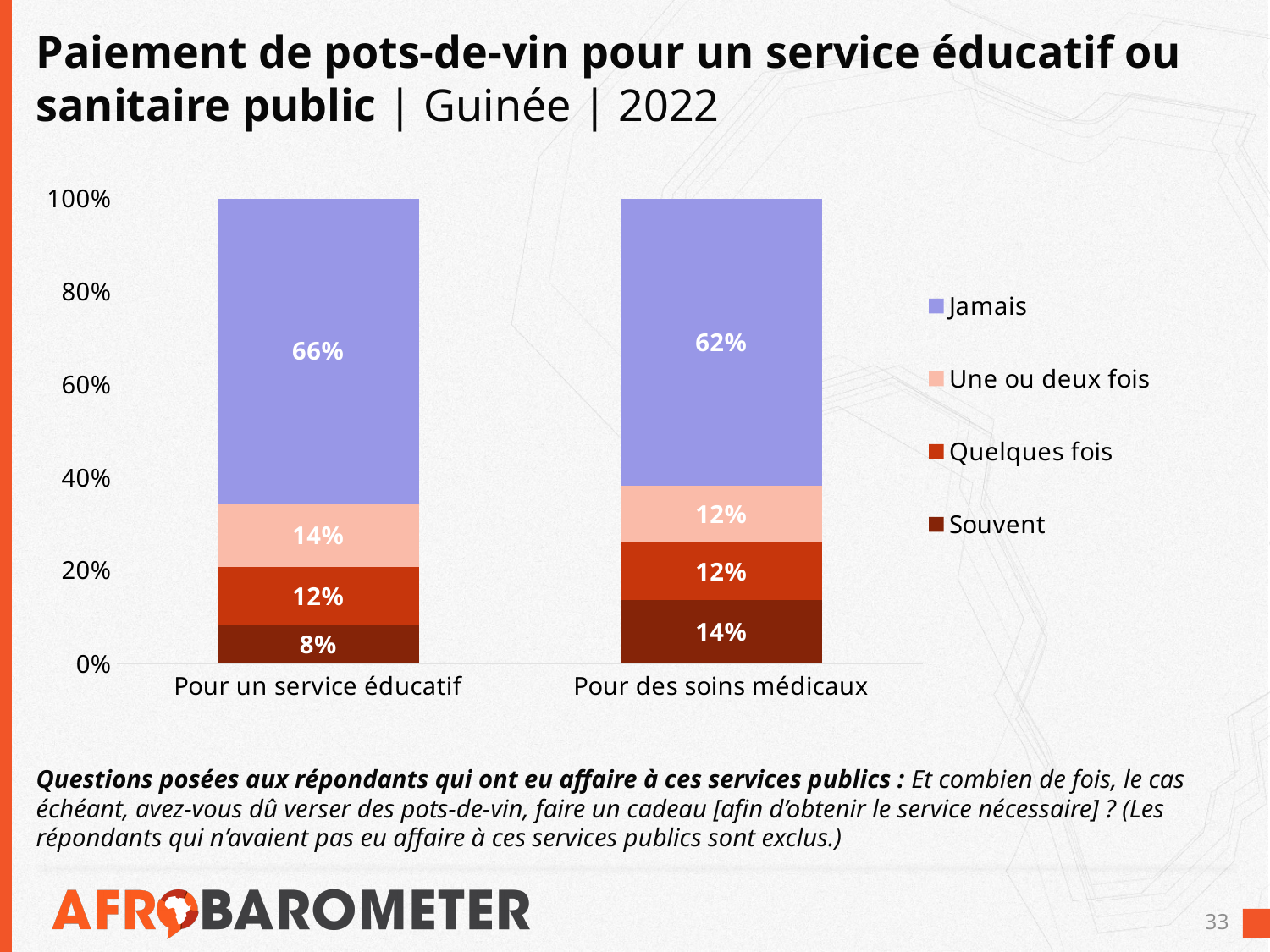
How many series does the legend list? 4 What kind of chart is shown on the slide? Stacked bar chart How many categories are shown on the x axis? 2 Which category has the higher "Souvent" value? Pour des soins médicaux Which category has the higher "Jamais" value, "Pour un service éducatif" or "Pour des soins médicaux"? Pour un service éducatif What is the value for "Quelques fois" in the "Pour un service éducatif" bar? 12% What is the value for "Une ou deux fois" in the "Pour des soins médicaux" bar? 12% What is the total of the stacked bar for "Pour un service éducatif"? 100% What is the difference between the "Souvent" values for "Pour des soins médicaux" and "Pour un service éducatif"? 6% What percentage of respondents answered "Jamais" for "Pour un service éducatif"? 66% What is the difference between the "Jamais" values for "Pour un service éducatif" and "Pour des soins médicaux"? 4% What percentage of respondents answered "Souvent" for "Pour des soins médicaux"? 14%